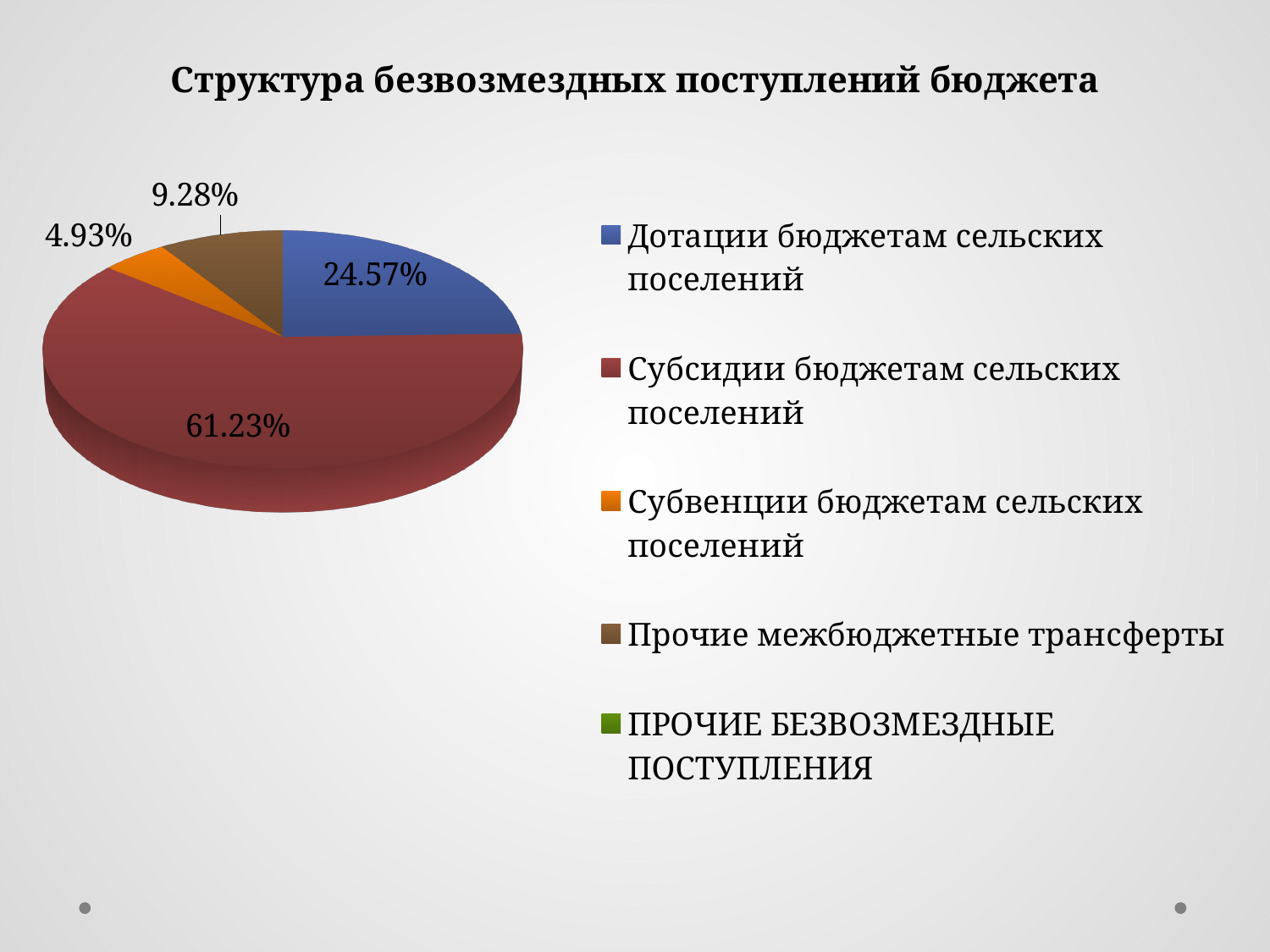
What share of the pie does Субсидии бюджетам сельских поселений have? 61.23% Which category has the largest slice of the pie? Субсидии бюджетам сельских поселений How many entries does the legend list? 5 What is the difference in percentage points between the Субсидии and Дотации slices? 36.66 Which is larger: the share for Дотации бюджетам сельских поселений or for Прочие межбюджетные трансферты? Дотации бюджетам сельских поселений What kind of chart is shown on the slide? Pie chart What share of the pie does Дотации бюджетам сельских поселений have? 24.57% What is the difference in percentage points between the Прочие межбюджетные трансферты and Субвенции slices? 4.35 Of the slices with printed values, which category has the smallest share? Субвенции бюджетам сельских поселений What share of the pie does Прочие межбюджетные трансферты have? 9.28% What share of the pie does Субвенции бюджетам сельских поселений have? 4.93% What is the title of the chart? Структура безвозмездных поступлений бюджета